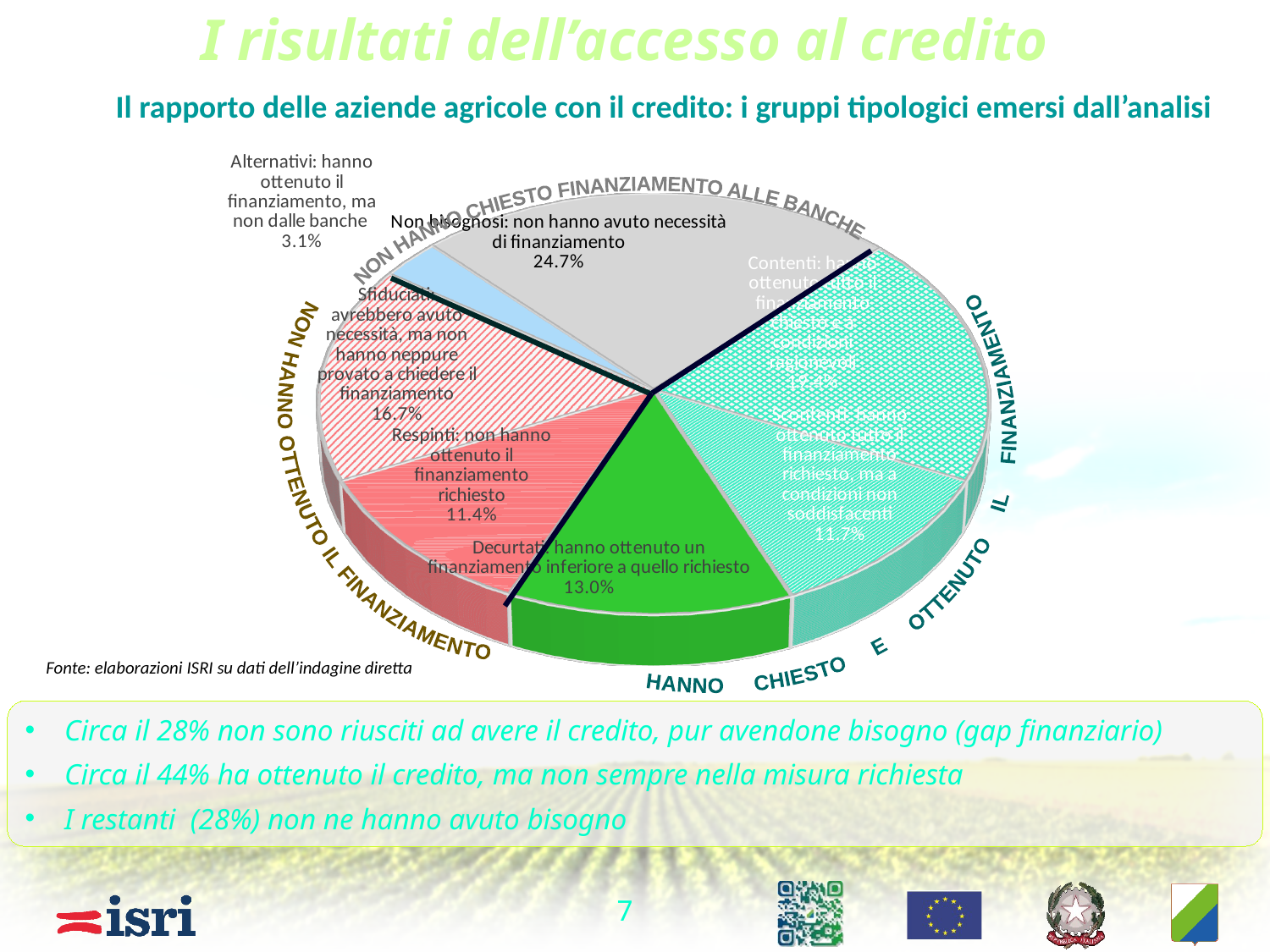
Which group has the smallest slice of the pie? Alternativi What share of the pie is 'Non bisognosi: non hanno avuto necessità di finanziamento'? 24.7% Which slice is larger, 'Decurtati' or 'Scontenti'? Decurtati What share of the pie is 'Alternativi: hanno ottenuto il finanziamento, ma non dalle banche'? 3.1% What share of the pie is 'Sfiduciati: avrebbero avuto necessità, ma non hanno neppure provato a chiedere il finanziamento'? 16.7% What is the difference in percentage points between the 'Sfiduciati' slice and the 'Respinti' slice? 5.3 What share of the pie is 'Decurtati: hanno ottenuto un finanziamento inferiore a quello richiesto'? 13.0% What share of the pie is 'Scontenti: hanno ottenuto tutto il finanziamento richiesto, ma a condizioni non soddisfacenti'? 11.7% What kind of chart is shown on the slide? Pie chart How many slices does the pie chart have? 7 What share of the pie is 'Respinti: non hanno ottenuto il finanziamento richiesto'? 11.4% Which group has the largest slice of the pie? Non bisognosi